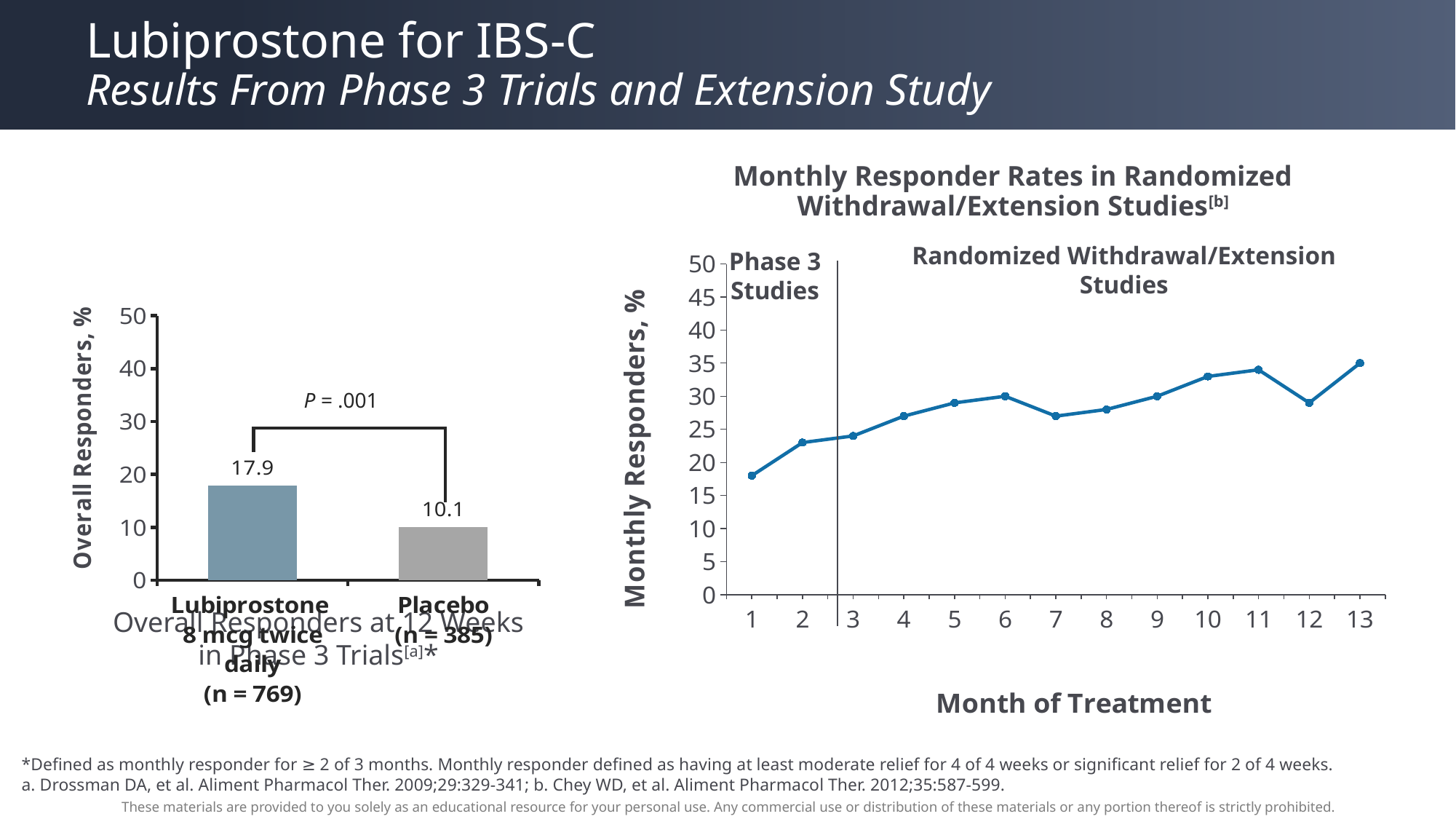
What kind of chart is the right chart (Monthly Responder Rates in Randomized Withdrawal/Extension Studies)? Line chart In the right chart (Monthly Responder Rates in Randomized Withdrawal/Extension Studies), which month has the lowest monthly responder rate? 1 In the left chart (Overall Responders at 12 Weeks in Phase 3 Trials), what P value is shown between the two bars? P = .001 In the right chart (Monthly Responder Rates in Randomized Withdrawal/Extension Studies), is the value for month 1 greater or less than 20? less In the left chart (Overall Responders at 12 Weeks in Phase 3 Trials), which group has the higher overall responder rate? Lubiprostone 8 mcg twice daily In the right chart (Monthly Responder Rates in Randomized Withdrawal/Extension Studies), what is the label of the x axis? Month of Treatment In the right chart (Monthly Responder Rates in Randomized Withdrawal/Extension Studies), is the value for month 13 greater or less than 30? greater In the right chart (Monthly Responder Rates in Randomized Withdrawal/Extension Studies), how many months of treatment are plotted on the x axis? 13 In the left chart (Overall Responders at 12 Weeks in Phase 3 Trials), what is the percentage of overall responders for Placebo? 10.1 What kind of chart is the left chart (Overall Responders at 12 Weeks in Phase 3 Trials)? Bar chart In the left chart (Overall Responders at 12 Weeks in Phase 3 Trials), what is the percentage of overall responders for Lubiprostone 8 mcg twice daily? 17.9 In the left chart (Overall Responders at 12 Weeks in Phase 3 Trials), what is the difference in overall responder percentage between Lubiprostone and Placebo? 7.8